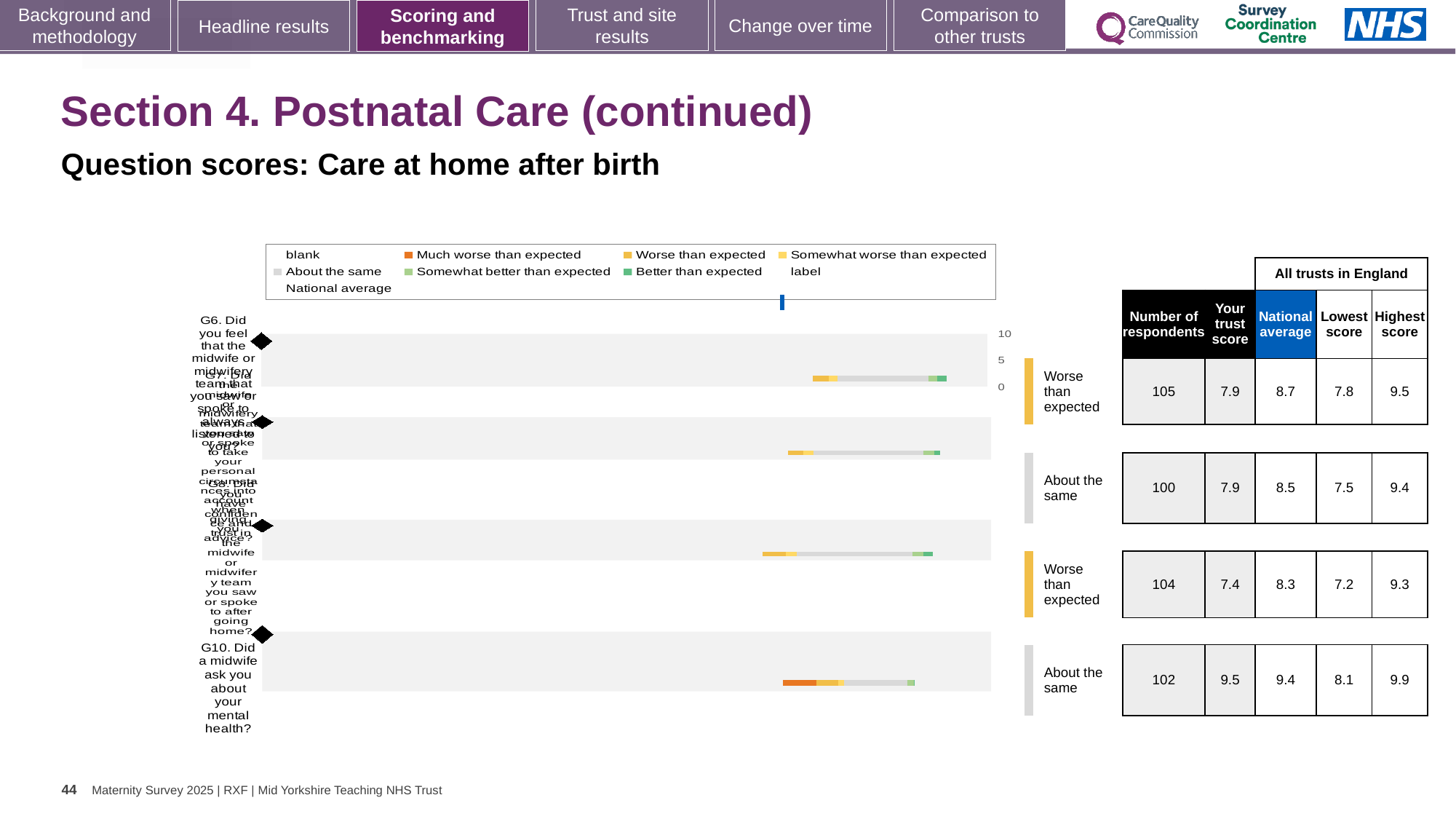
What is the difference between the trust score and the national average for G10? 0.1 What is the number of respondents for G10 (Did a midwife ask you about your mental health?)? 102 What is the difference between the highest and lowest scores for G6? 1.7 How many questions (rows) are plotted in the chart? 4 For G6, which is larger: the trust score or the national average? National average What is the highest score among all trusts in England for G6? 9.5 What kind of chart is used to show the question scores on this slide? bar chart What benchmark category is shown for G10? About the same What is the national average for G10? 9.4 What is the trust score for G6 (Did you feel that the midwife or midwifery team listened to you?)? 7.9 What is the lowest trust score shown in the table? 7.4 Which question has the highest trust score? G10